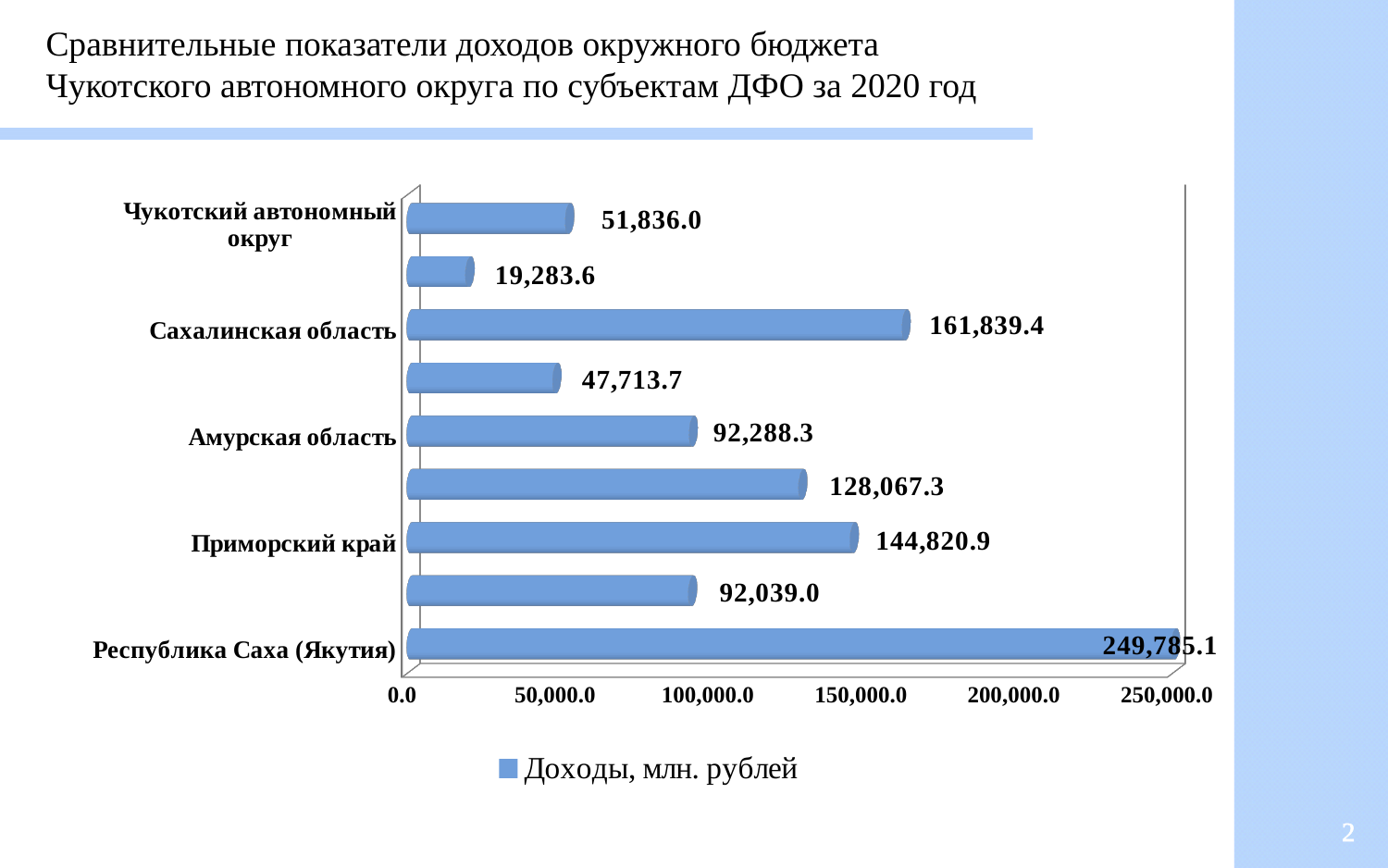
What is the value for Сахалинская область? 161,839.4 Which is larger, the value for Приморский край or the value for Амурская область? Приморский край What is the smallest value printed on the chart? 19,283.6 What kind of chart is shown on the slide? bar chart What is the legend entry of the chart? Доходы, млн. рублей How many bars are plotted on the chart? 9 What is the value for Республика Саха (Якутия)? 249,785.1 What is the value for Чукотский автономный округ? 51,836.0 What is the difference between the values for Сахалинская область and Чукотский автономный округ? 110,003.4 Is the value for Чукотский автономный округ greater or less than 100,000.0? less Which labelled region has the highest value? Республика Саха (Якутия) What is the value for Приморский край? 144,820.9